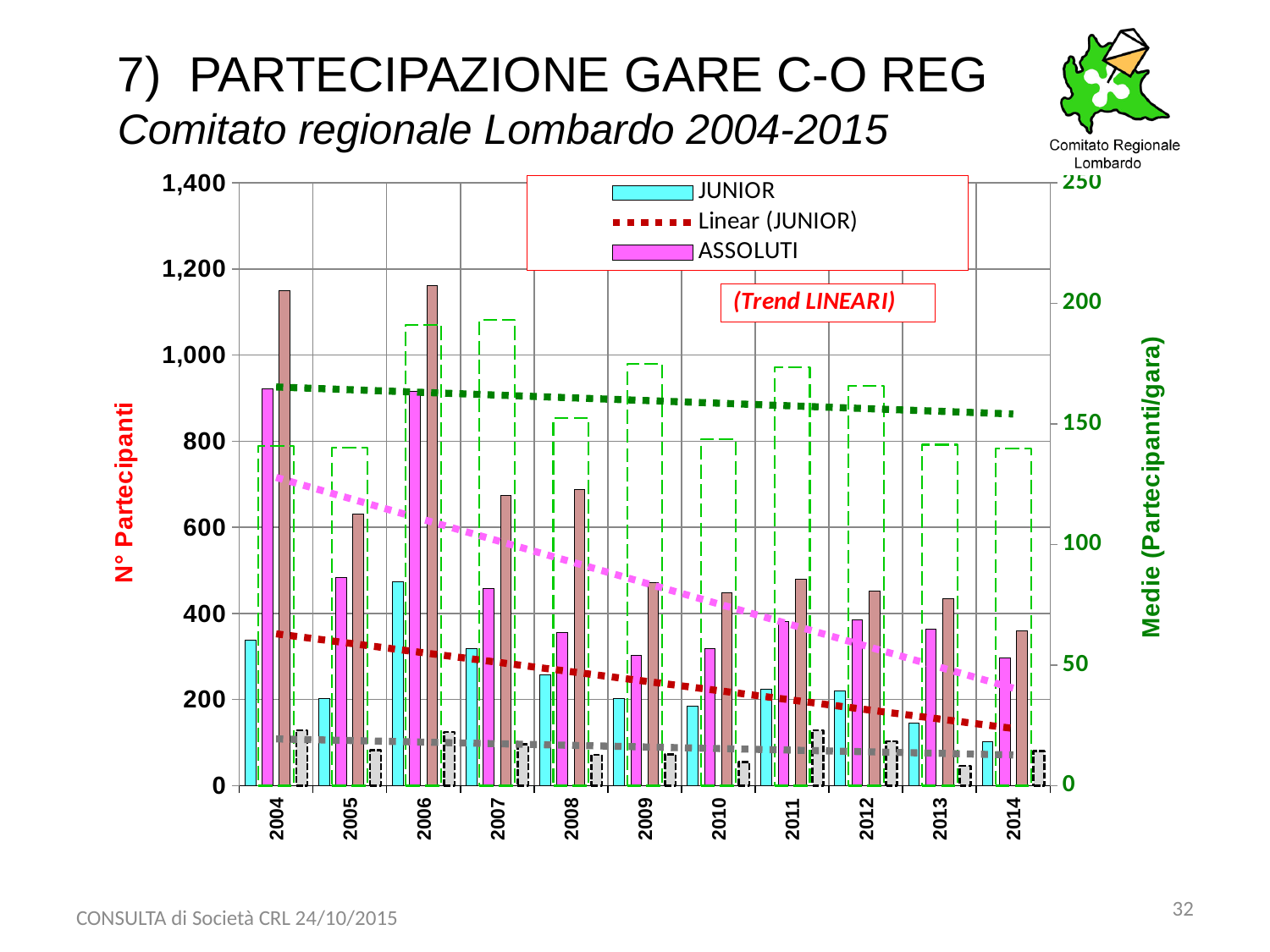
Is the JUNIOR value for 2006 greater or less than 400? greater Is the ASSOLUTI value for 2014 greater or less than 400? less What is the title of the left vertical axis? N° Partecipanti Which year has the lowest JUNIOR value? 2014 Does the Linear (JUNIOR) trend line rise or fall from 2004 to 2014? fall Is the ASSOLUTI value for 2004 greater or less than 800? greater Which year has the highest JUNIOR value? 2006 What kind of chart is shown on the slide? bar chart What is the title of the right vertical axis? Medie (Partecipanti/gara) How many years are shown along the x axis of the chart? 11 Which is larger, the ASSOLUTI value for 2004 or for 2014? 2004